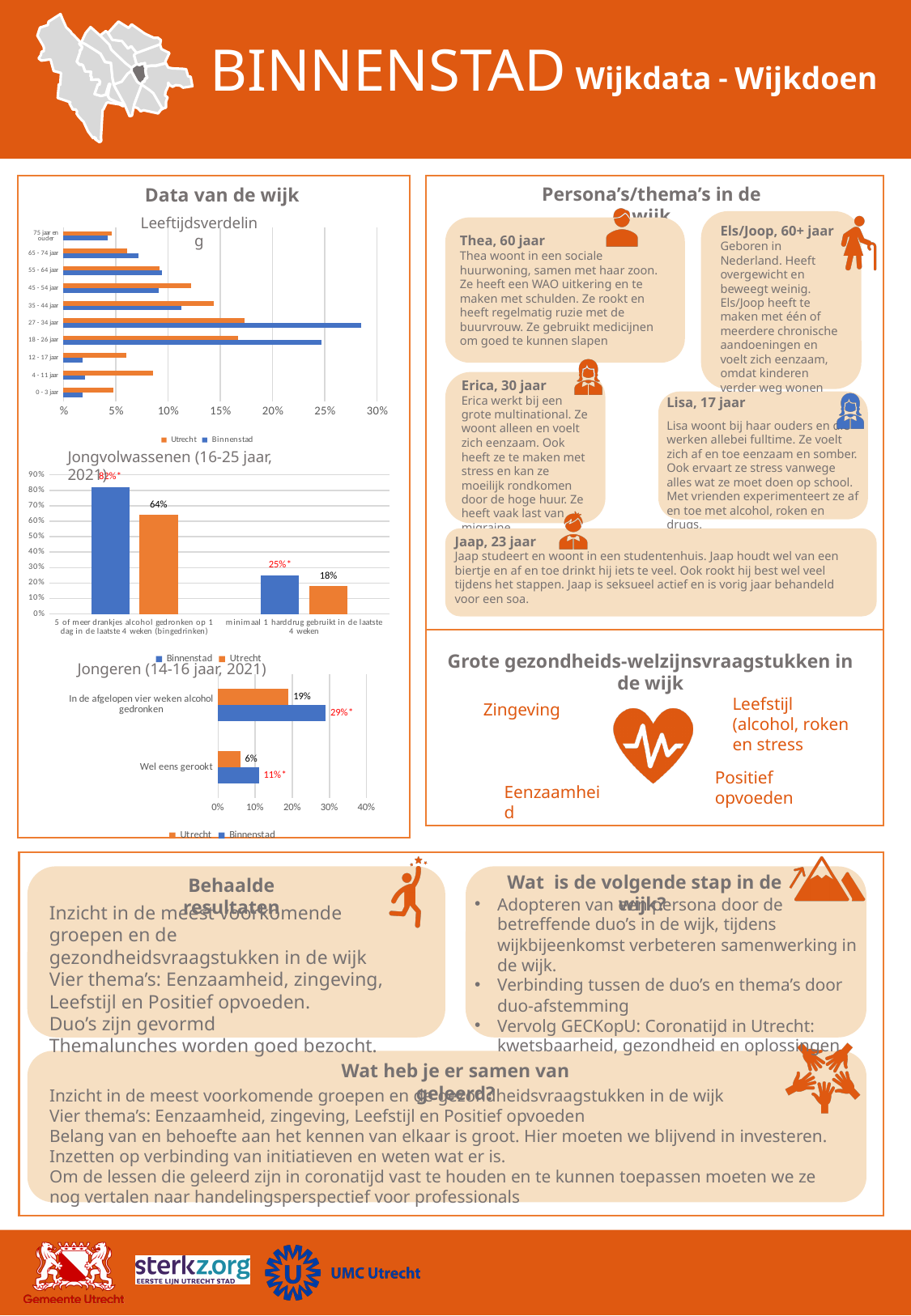
In the 'Jongvolwassenen (16-25 jaar, 2021)' chart, which is larger for harddrug use: Binnenstad or Utrecht? Binnenstad How many age categories does the 'Leeftijdsverdeling' chart show? 10 In the 'Jongeren (14-16 jaar, 2021)' chart, what is the difference between the Binnenstad and Utrecht values for 'Wel eens gerookt'? 5 percentage points In the 'Jongvolwassenen (16-25 jaar, 2021)' chart, what is the difference between the Binnenstad and Utrecht values for harddrug use? 7 percentage points In the 'Jongvolwassenen (16-25 jaar, 2021)' chart, what is the Utrecht value for '5 of meer drankjes alcohol gedronken op 1 dag in de laatste 4 weken (bingedrinken)'? 64% In the 'Jongeren (14-16 jaar, 2021)' chart, what is the Utrecht value for 'Wel eens gerookt'? 6% In the 'Leeftijdsverdeling' chart, is the Binnenstad value for '27 - 34 jaar' greater or less than 25%? greater In the 'Jongvolwassenen (16-25 jaar, 2021)' chart, what is the Binnenstad value for 'minimaal 1 harddrug gebruikt in de laatste 4 weken'? 25%* In the 'Leeftijdsverdeling' chart, which age category has the highest Binnenstad value? 27 - 34 jaar What type of chart is the 'Leeftijdsverdeling' chart? Bar chart How many series does the legend of the 'Jongeren (14-16 jaar, 2021)' chart list? 2 In the 'Jongeren (14-16 jaar, 2021)' chart, what is the Binnenstad value for 'In de afgelopen vier weken alcohol gedronken'? 29%*